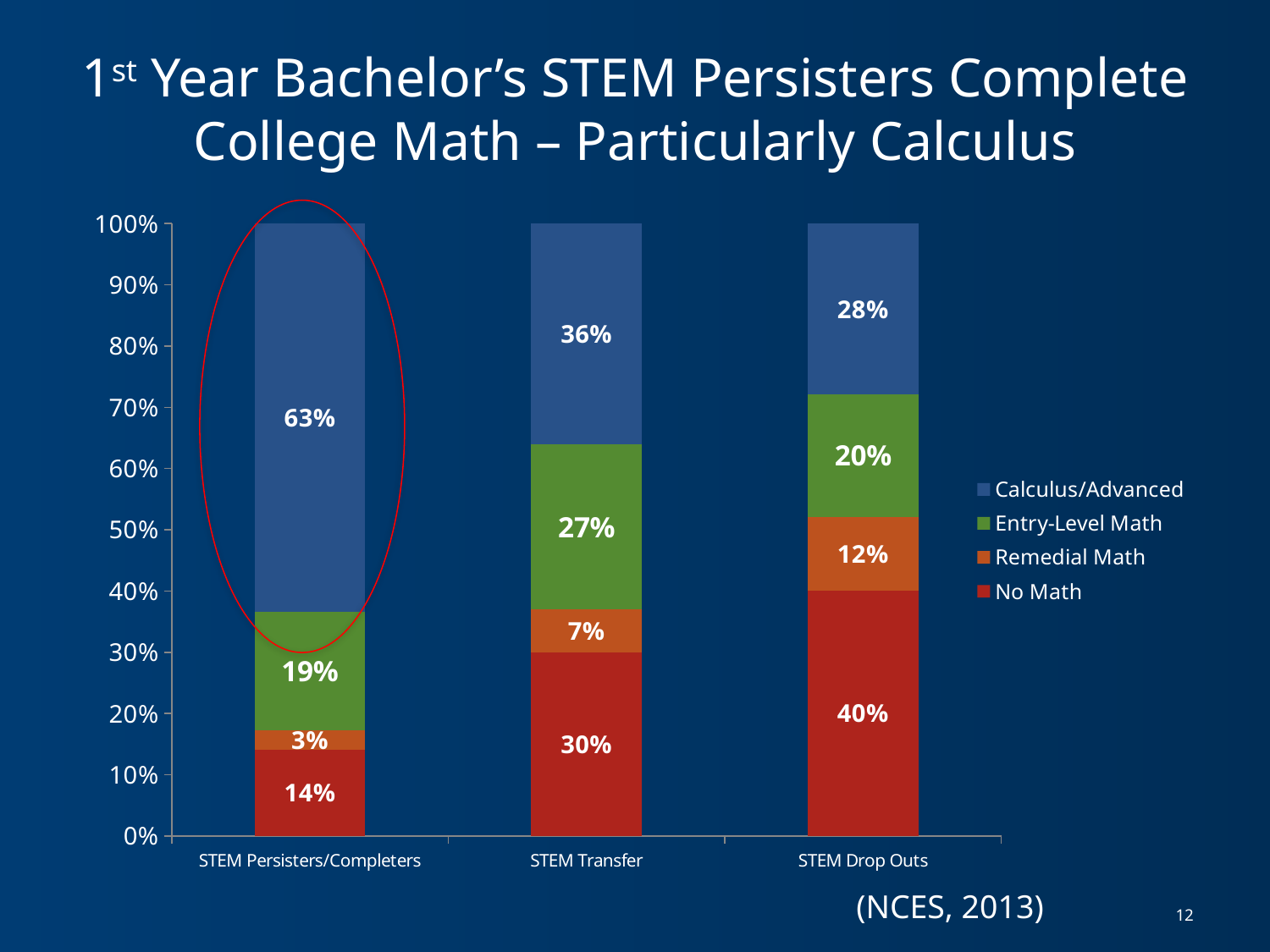
What is the Entry-Level Math value for STEM Drop Outs? 20% What is the difference between the Calculus/Advanced values for STEM Persisters/Completers and STEM Transfer? 27% Which category has the highest Calculus/Advanced share? STEM Persisters/Completers What percentage of STEM Persisters/Completers took Calculus/Advanced math? 63% Which is larger: the No Math value for STEM Transfer or for STEM Drop Outs? STEM Drop Outs What kind of chart is shown on the slide? Stacked bar chart How many categories are shown on the x axis? 3 What is the Remedial Math value for STEM Transfer? 7% Which legend entry is shown in green? Entry-Level Math What is the No Math value for STEM Drop Outs? 40% How many series does the legend list? 4 Which category has the lowest Remedial Math share? STEM Persisters/Completers